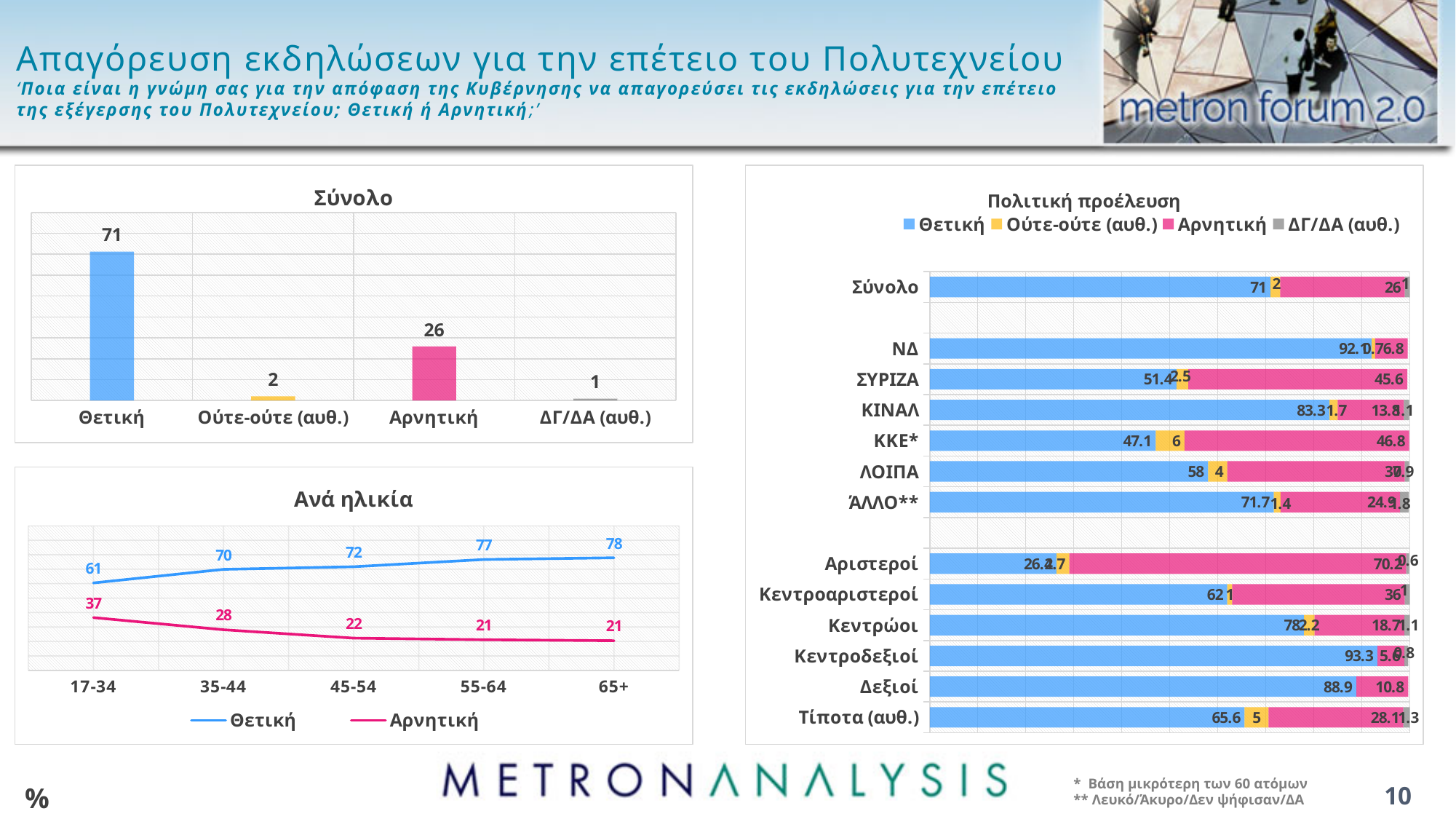
In the 'Σύνολο' chart, which category has the lowest value? ΔΓ/ΔΑ (αυθ.) How many age groups are shown on the x axis of the 'Ανά ηλικία' chart? 5 In the 'Πολιτική προέλευση' chart, which group has the lowest Θετική value? Αριστεροί In the 'Ανά ηλικία' chart, what is the Αρνητική value for the 65+ age group? 21 In the 'Σύνολο' chart, what is the value for Θετική? 71 In the 'Ανά ηλικία' chart, does the Θετική line rise or fall from 17-34 to 65+? Rises How many series does the legend of the 'Πολιτική προέλευση' chart list? 4 In the 'Ανά ηλικία' chart, what is the Θετική value for the 17-34 age group? 61 In the 'Σύνολο' chart, what is the value for Αρνητική? 26 What kind of chart is the 'Ανά ηλικία' chart? Line chart In the 'Σύνολο' chart, what is the difference between Θετική and Αρνητική? 45 In the 'Πολιτική προέλευση' chart, what is the Θετική value for ΣΥΡΙΖΑ? 51.4